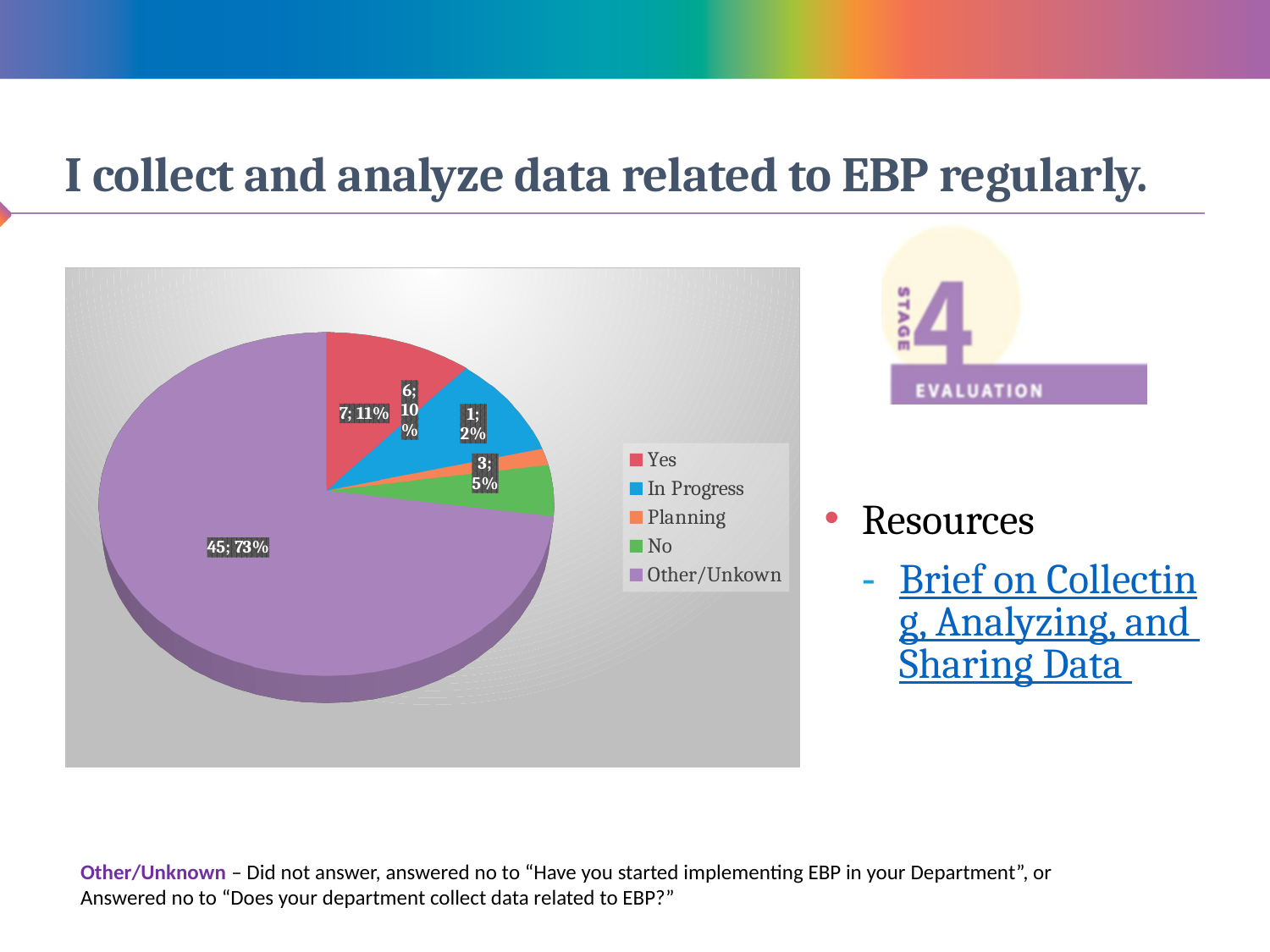
What colour is the Other/Unknown slice? Purple What is the difference in count between the Yes slice and the No slice? 4 Which category has the largest slice? Other/Unknown What count is shown for the Yes slice? 7 How many slices does the pie chart have? 5 What kind of chart is shown on the slide? Pie chart Which category has the smallest slice? Planning How many entries does the legend list? 5 What count is shown for the Other/Unknown slice? 45 What percentage share does the In Progress slice have? 10% What percentage share does the Other/Unknown slice have? 73% Which is larger, the In Progress slice or the No slice? In Progress